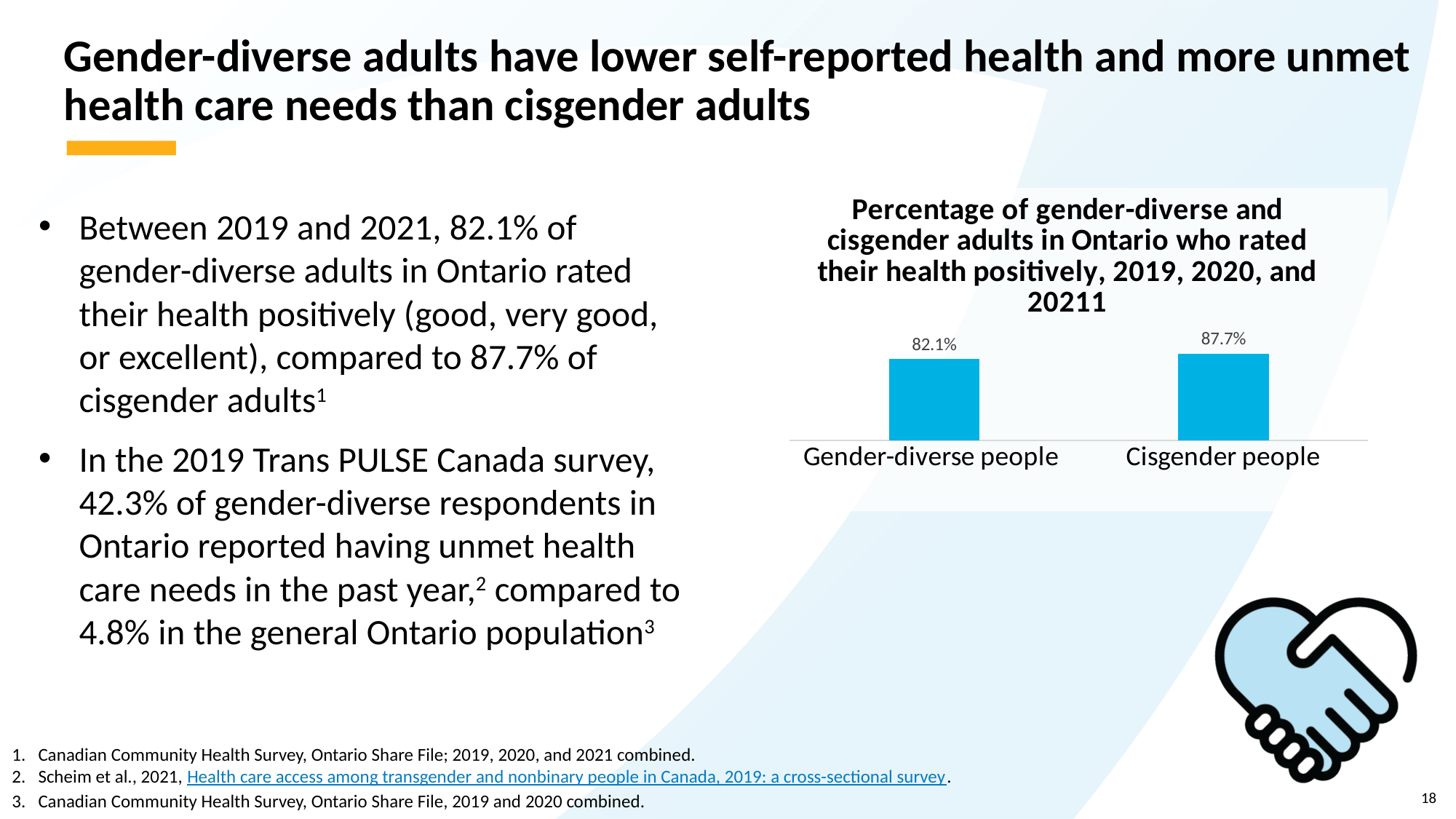
What percentage of cisgender people rated their health positively according to the chart? 87.7% Is the value for gender-diverse people larger or smaller than the value for cisgender people? smaller What percentage of gender-diverse people rated their health positively according to the chart? 82.1% Which group has the higher percentage of people who rated their health positively? Cisgender people What is the title of the chart? Percentage of gender-diverse and cisgender adults in Ontario who rated their health positively, 2019, 2020, and 2021 What is the difference in percentage points between cisgender people and gender-diverse people who rated their health positively? 5.6 How many categories are shown on the chart? 2 What kind of chart is shown on the slide? Bar chart Which group has the lower percentage of people who rated their health positively? Gender-diverse people What colour are the bars in the chart? Blue